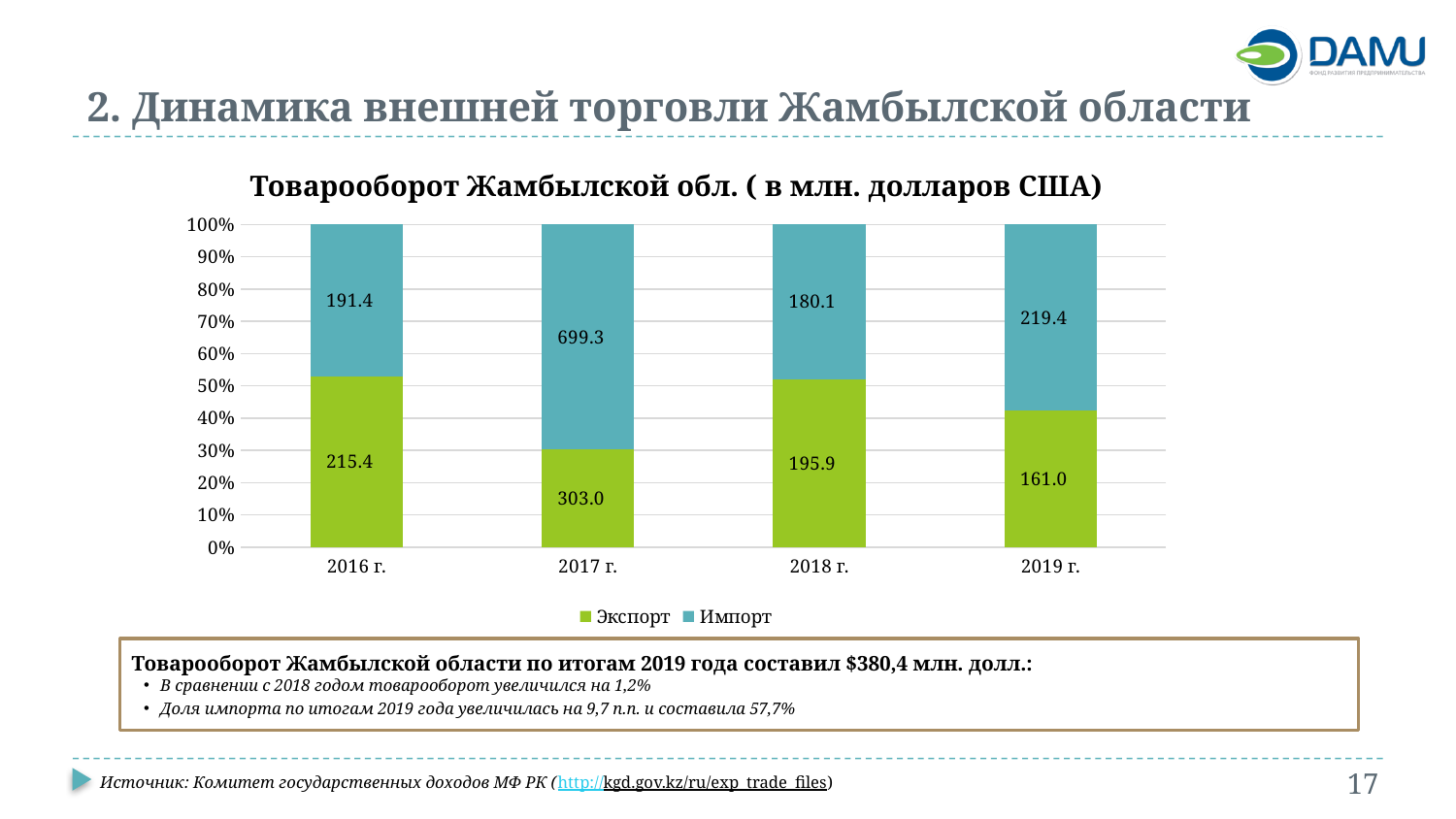
What is the value of Импорт for 2016 г.? 191.4 Which is larger in 2018 г., Экспорт or Импорт? Экспорт How many years are shown on the x axis? 4 What is the difference between Импорт and Экспорт in 2017 г.? 396.3 How many series does the legend list? 2 What is the value of Импорт for 2019 г.? 219.4 Which year has the highest Импорт value? 2017 г. What is the total of Экспорт and Импорт for 2019 г.? 380.4 What is the value of Экспорт for 2017 г.? 303.0 Which year has the lowest Экспорт value? 2019 г. What kind of chart is shown? Stacked bar chart What colour represents Экспорт in the chart? Green